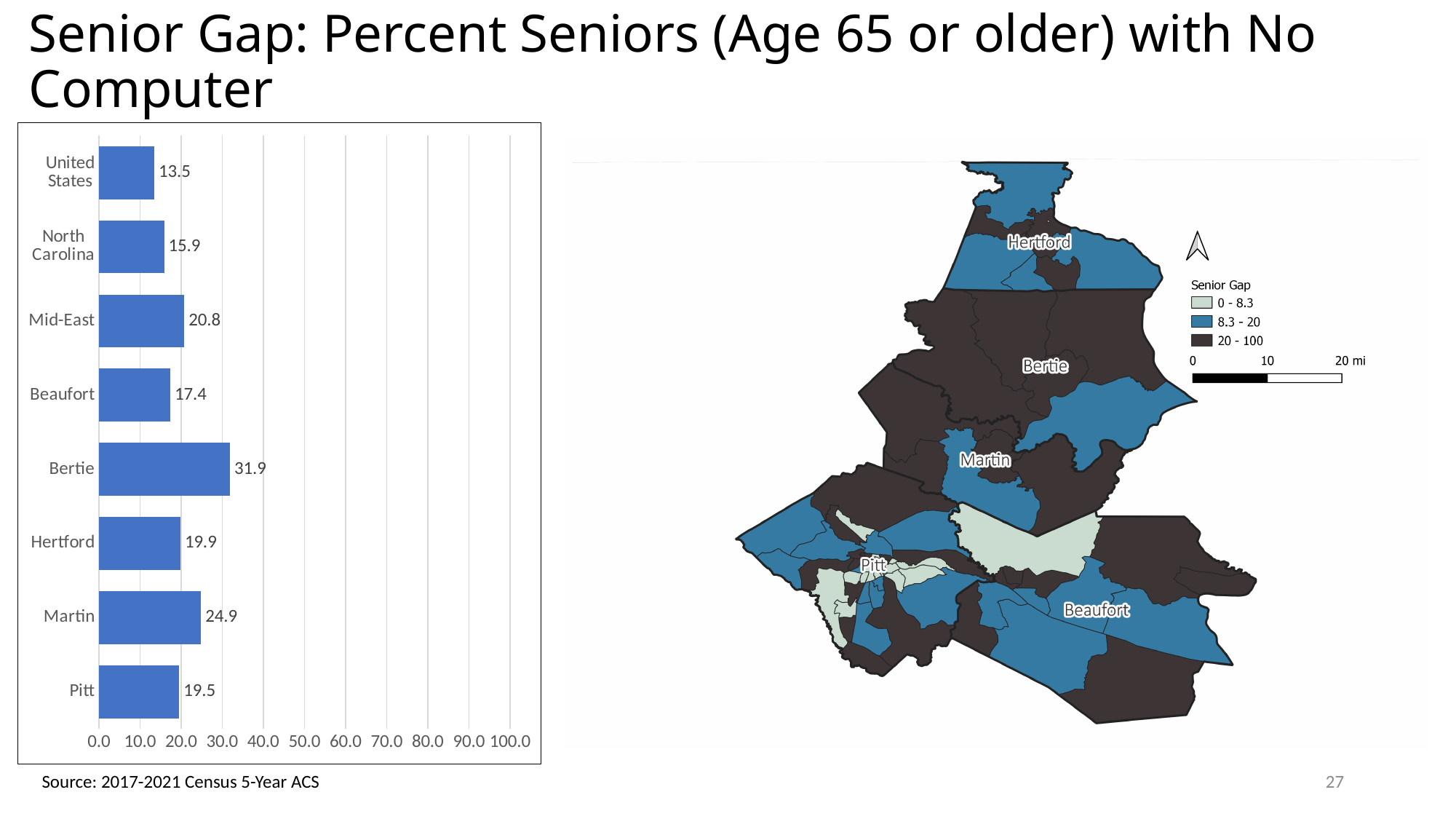
Which category has the highest value in the bar chart? Bertie What is the value for Pitt in the bar chart? 19.5 Which category has the lowest value in the bar chart? United States What is the difference between the values for Bertie and Martin in the bar chart? 7.0 What is the value for Bertie in the bar chart? 31.9 What is the highest value shown on the x axis of the bar chart? 100.0 What kind of chart is shown on the left of the slide? Bar chart What is the value for Mid-East in the bar chart? 20.8 Which has a larger value in the bar chart, Beaufort or Hertford? Hertford What is the difference between the values for North Carolina and the United States in the bar chart? 2.4 What is the value for the United States in the bar chart? 13.5 How many categories are shown in the bar chart? 8